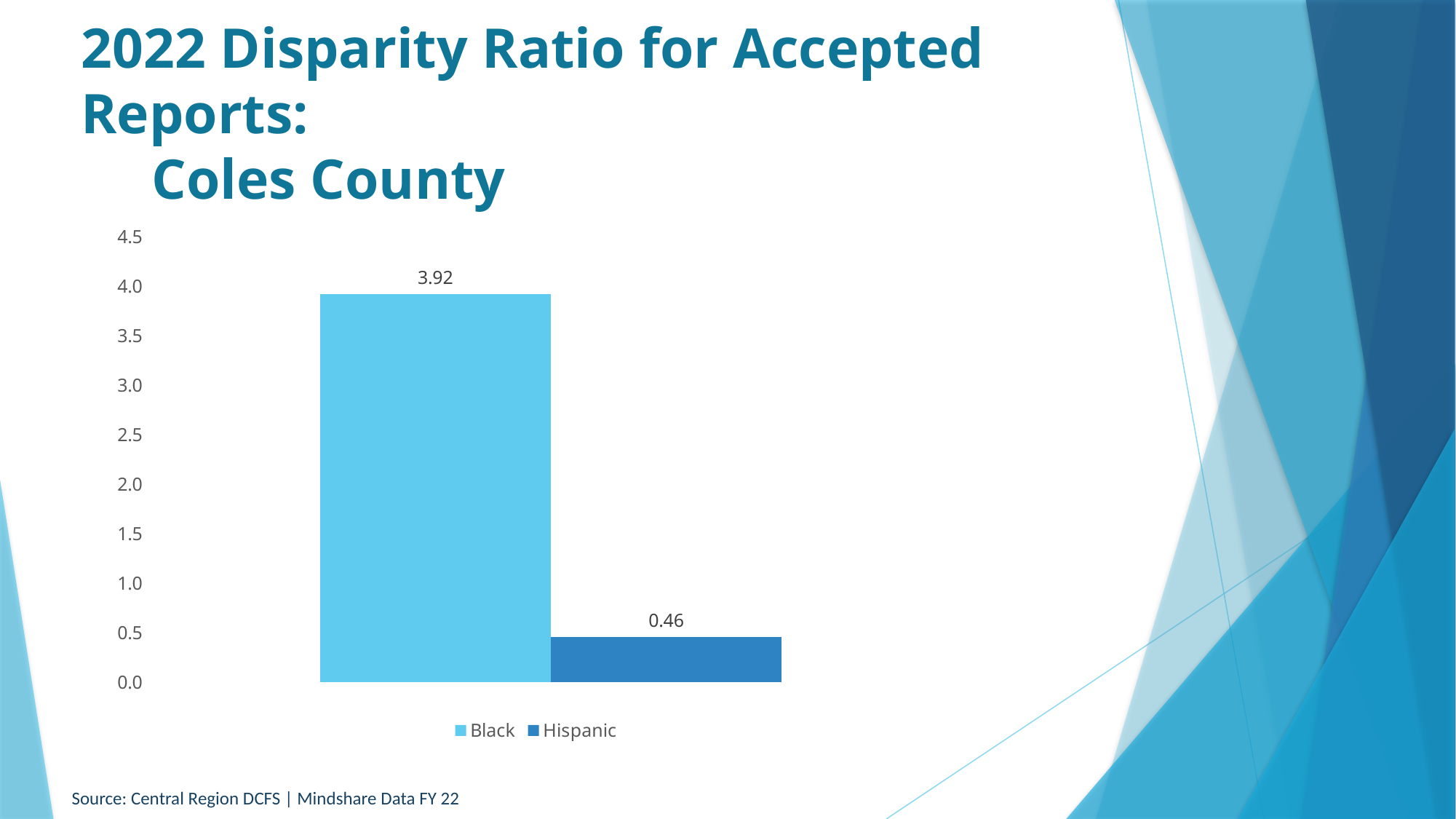
What kind of chart is shown on the slide? Bar chart Which is larger, the disparity ratio for Black or for Hispanic? Black What is the difference between the Black and Hispanic disparity ratios? 3.46 Which group has the lowest disparity ratio? Hispanic Is the disparity ratio for Black greater or less than 3.5? greater Is the disparity ratio for Hispanic greater or less than 1.0? less What is the disparity ratio for Hispanic in the chart? 0.46 What is the highest value shown on the vertical axis? 4.5 What is the disparity ratio for Black in the chart? 3.92 How many series does the legend list? 2 Which group has the highest disparity ratio? Black Which county does the chart's title refer to? Coles County